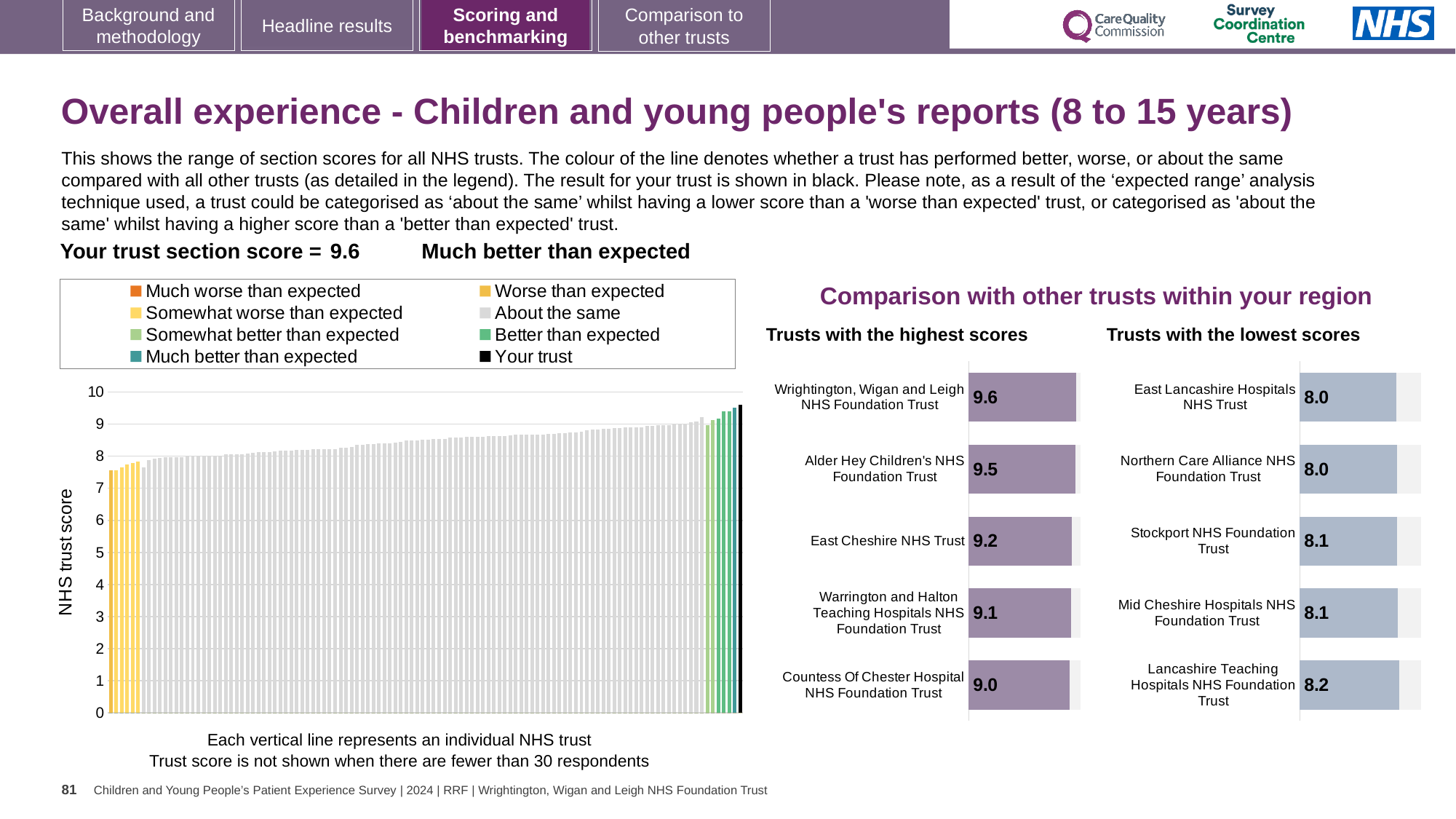
In the 'Trusts with the highest scores' chart, which trust has the lowest score? Countess Of Chester Hospital NHS Foundation Trust How many trusts are listed in the 'Trusts with the lowest scores' chart? 5 In the 'Trusts with the highest scores' chart, what is the score for Alder Hey Children's NHS Foundation Trust? 9.5 In the 'Trusts with the highest scores' chart, which has the larger score: Alder Hey Children's NHS Foundation Trust or Warrington and Halton Teaching Hospitals NHS Foundation Trust? Alder Hey Children's NHS Foundation Trust In the large chart on the left showing the range of NHS trust scores, do the bars rise or fall from left to right? rise In the 'Trusts with the highest scores' chart, what is the difference between the scores of Wrightington, Wigan and Leigh NHS Foundation Trust and Countess Of Chester Hospital NHS Foundation Trust? 0.6 In the 'Trusts with the lowest scores' chart, which trust has the highest score? Lancashire Teaching Hospitals NHS Foundation Trust In the 'Trusts with the highest scores' chart, what is the score for East Cheshire NHS Trust? 9.2 In the 'Trusts with the lowest scores' chart, what is the score for Stockport NHS Foundation Trust? 8.1 How many entries does the legend of the large chart on the left list? 8 In the large chart on the left, is the value of the leftmost (lowest) bar greater or less than 7? greater In the 'Trusts with the lowest scores' chart, what is the difference between the scores of Lancashire Teaching Hospitals NHS Foundation Trust and East Lancashire Hospitals NHS Trust? 0.2